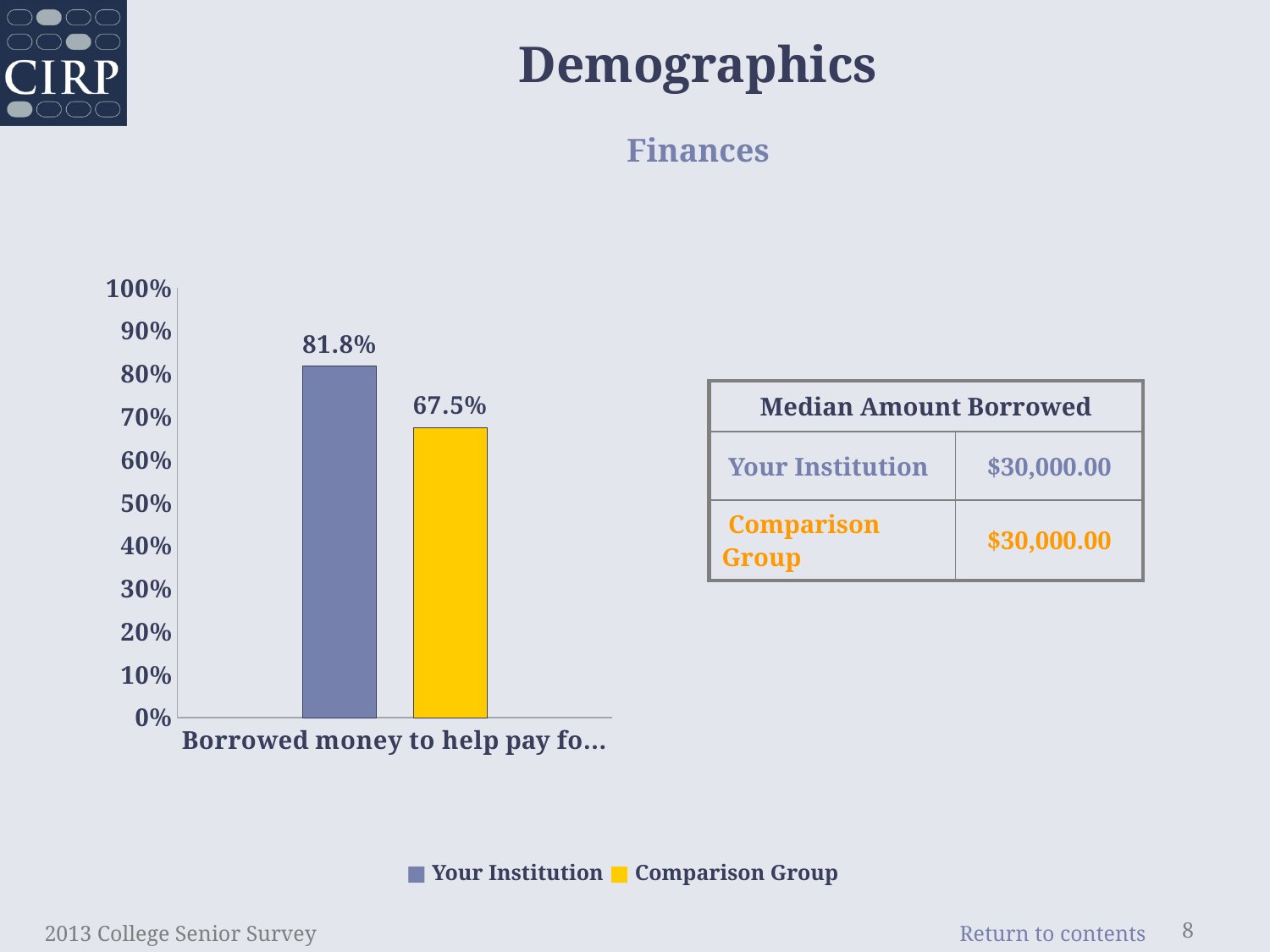
What is the value for Your Institution in the bar chart? 81.8% What is the difference between the Your Institution and Comparison Group values in the bar chart? 14.3% What is the value for Comparison Group in the bar chart? 67.5% How many series does the legend of the bar chart list? 2 Is the value for Comparison Group in the bar chart greater or less than 70%? less What colour is the Comparison Group bar in the bar chart? yellow What is the maximum value shown on the y axis of the bar chart? 100% How many categories are shown on the x axis of the bar chart? 1 Is the value for Your Institution in the bar chart greater or less than 80%? greater Which series has the lowest value in the bar chart? Comparison Group What kind of chart is shown on the slide? bar chart Which series has the higher value in the bar chart, Your Institution or Comparison Group? Your Institution